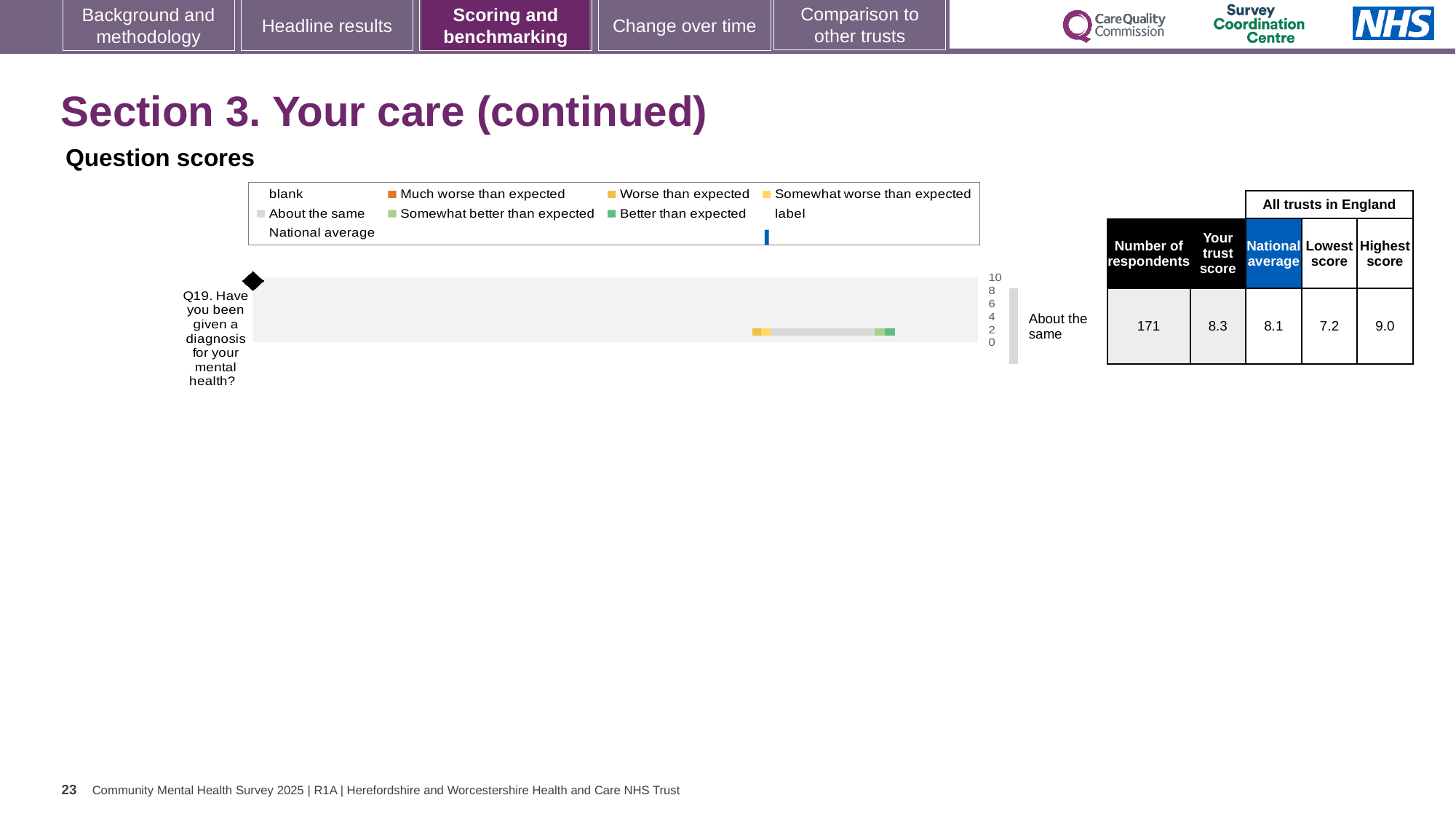
What is the national average for Q19? 8.1 What is the highest score among all trusts in England for Q19? 9.0 What is the lowest score among all trusts in England for Q19? 7.2 Which question is plotted in the Question scores chart? Q19. Have you been given a diagnosis for your mental health? For Q19, which is larger: the trust's score or the national average? the trust's score How many questions are plotted in the Question scores chart? 1 What benchmark category is shown next to the bar for Q19? About the same For Q19, what is the difference between the highest and lowest scores among all trusts in England? 1.8 What is the trust's score for Q19? 8.3 What kind of chart is shown under "Question scores"? bar chart What is the number of respondents for Q19? 171 Which legend entry is shown in dark green in the Question scores chart? Better than expected